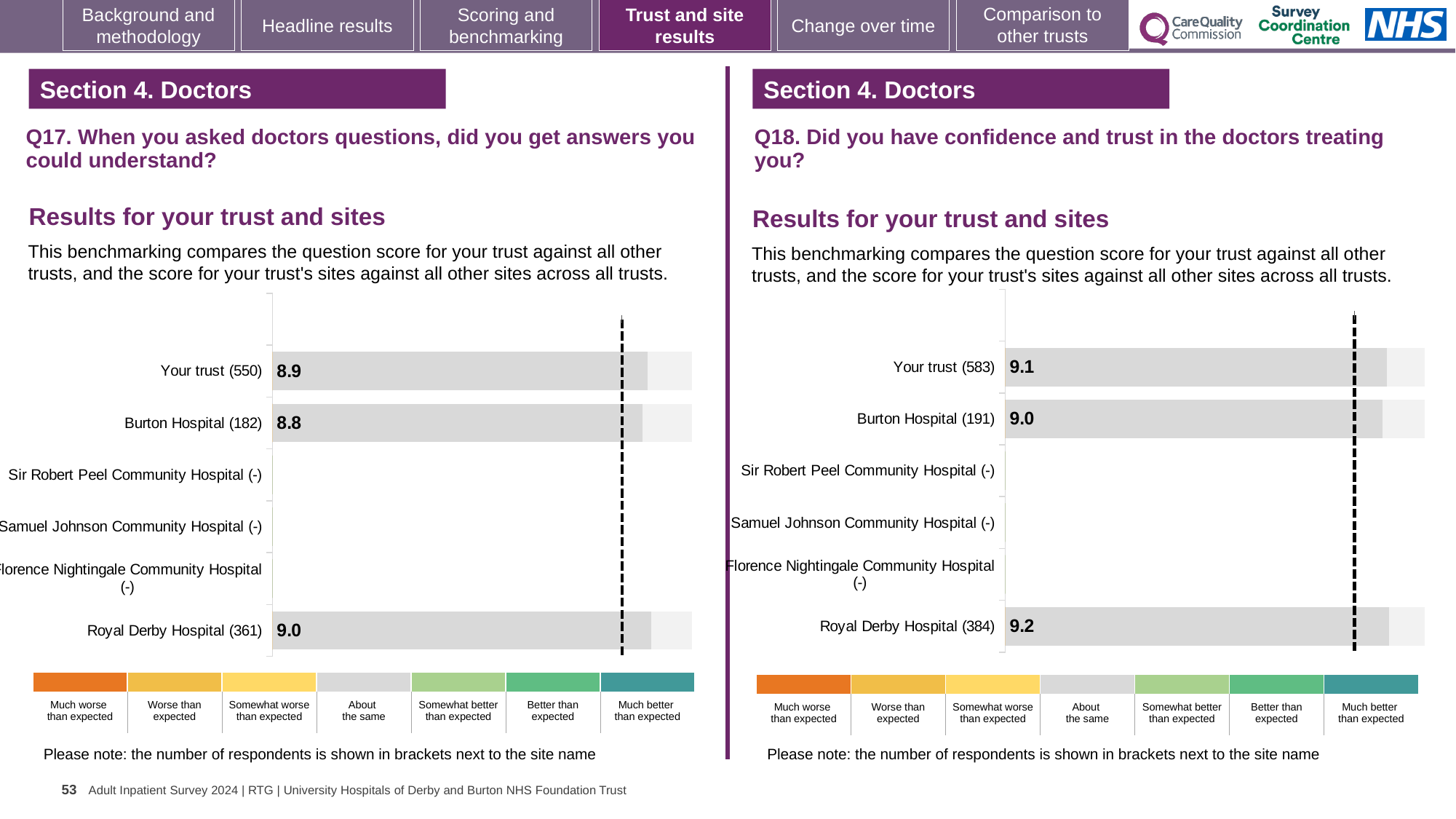
In the Q18 chart on the right, what is the score for Your trust (583)? 9.1 In the Q17 chart on the left, what is the score for Royal Derby Hospital (361)? 9.0 How many site/trust categories are listed on the y axis of the Q17 chart on the left? 6 In the Q18 chart on the right, which site has the lowest printed score? Burton Hospital (191) In the Q17 chart on the left, what is the score for Your trust (550)? 8.9 In the Q18 chart on the right, which has the higher score, Your trust or Burton Hospital? Your trust What type of chart is used for the Q18 results on the right? Bar chart In the Q17 chart on the left, which site has the highest printed score? Royal Derby Hospital (361) In the Q17 chart on the left, what is the difference between the scores for Royal Derby Hospital and Burton Hospital? 0.2 In the Q18 chart on the right, what is the score for Royal Derby Hospital (384)? 9.2 In the Q17 chart on the left, what is the score for Burton Hospital (182)? 8.8 In the Q18 chart on the right, what is the difference between the scores for Royal Derby Hospital and Your trust? 0.1